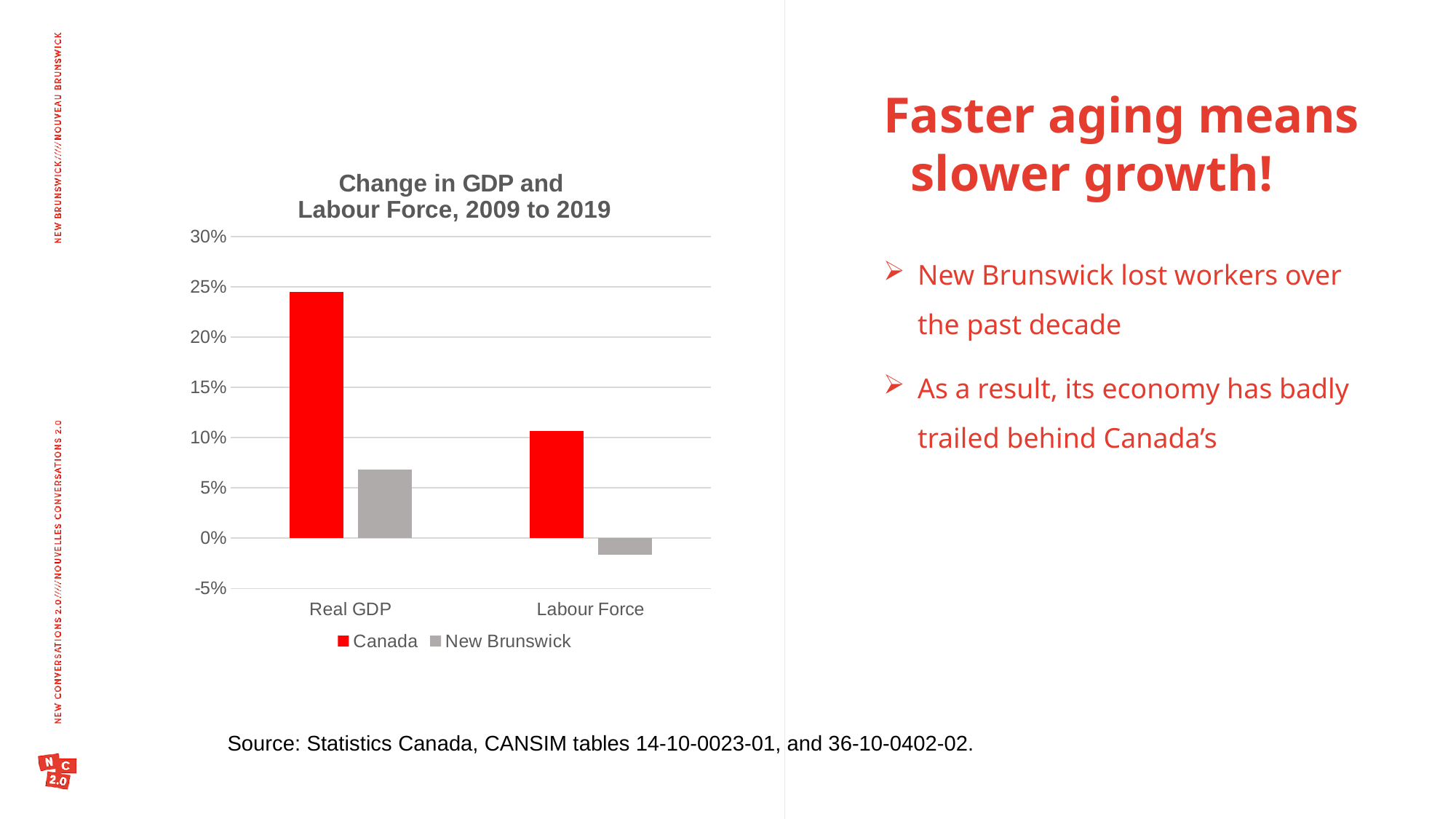
Is the value for Canada's Labour Force greater or less than 5%? greater How many series does the legend list? 2 How many categories are shown on the x axis? 2 Is the value for New Brunswick's Labour Force greater or less than 0%? less Which is larger for Real GDP, Canada or New Brunswick? Canada What is the title of the chart? Change in GDP and Labour Force, 2009 to 2019 Which series is shown in red? Canada Is the value for New Brunswick's Real GDP greater or less than 10%? less What kind of chart is shown on the slide? bar chart Which category has the highest Canada value? Real GDP Which series has the lowest value in the chart? New Brunswick